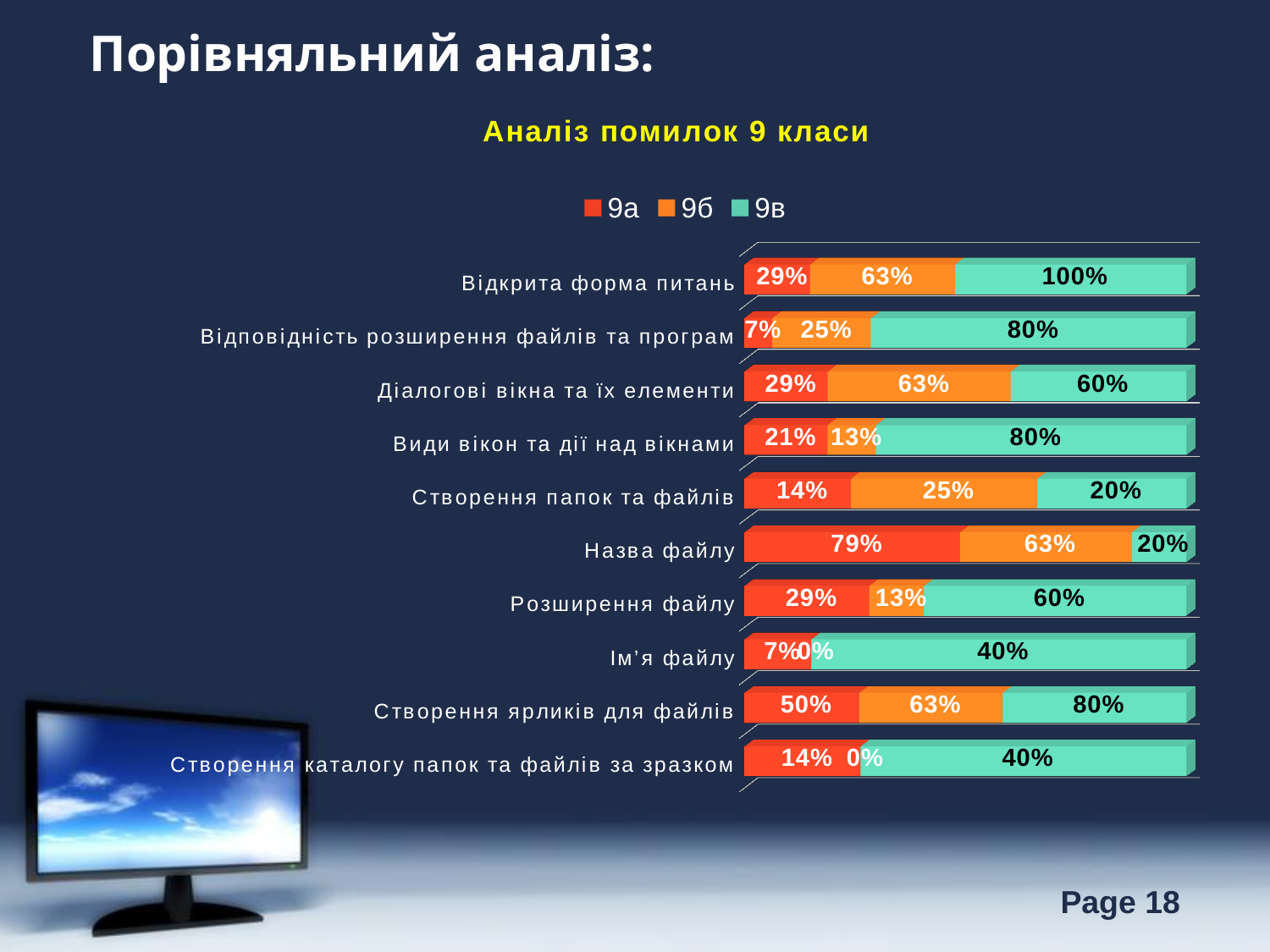
What is the value for 9в in the category 'Відкрита форма питань'? 100% What is the value for 9а in the category 'Назва файлу'? 79% Which category has the highest value for 9в? Відкрита форма питань What type of chart is shown on the slide? Stacked bar chart Which category has the highest value for 9а? Назва файлу What is the difference between the 9в and 9а values in the category 'Створення ярликів для файлів'? 30% How many categories are shown on the chart? 10 What is the title of the chart? Аналіз помилок 9 класи What is the value for 9в in the category 'Створення ярликів для файлів'? 80% Which is larger in the category 'Створення папок та файлів': the value for 9б or the value for 9в? 9б What is the value for 9б in the category 'Види вікон та дії над вікнами'? 13% How many series does the legend list? 3